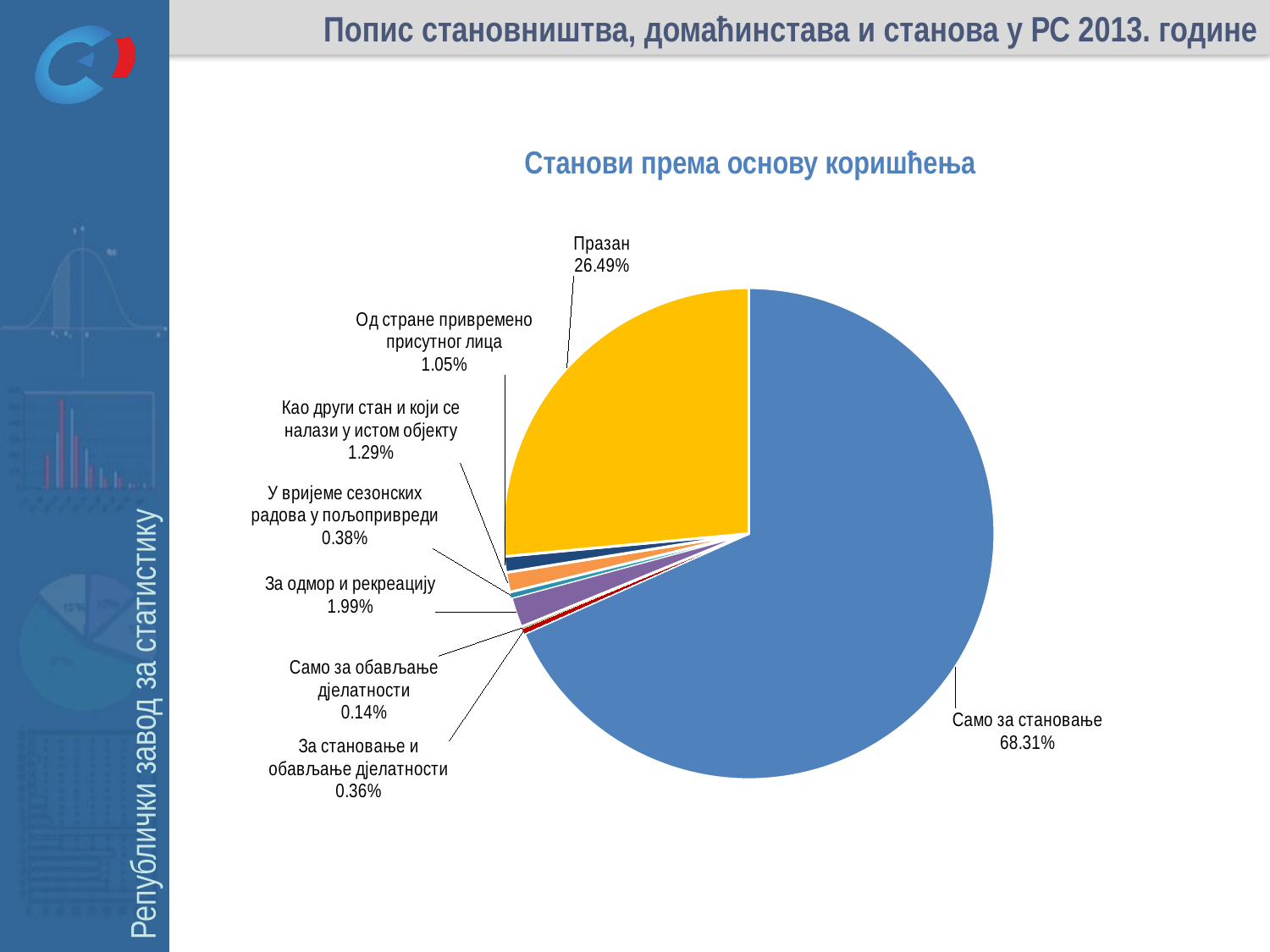
What is the difference in percentage points between "Само за становање" and "Празан"? 41.82 Which is larger: "За одмор и рекреацију" or "Као други стан и који се налази у истом објекту"? За одмор и рекреацију Which category has the largest slice of the pie? Само за становање What share of the pie is labelled "Само за становање"? 68.31% What kind of chart is shown on the slide? pie chart What is the title of the chart? Станови према основу коришћења How many slices does the pie chart have? 8 What percentage is shown for "Празан"? 26.49% What percentage is shown for "Од стране привремено присутног лица"? 1.05% Which category has the smallest slice of the pie? Само за обављање дјелатности What percentage is shown for "У вријеме сезонских радова у пољопривреди"? 0.38% What percentage is shown for "За одмор и рекреацију"? 1.99%